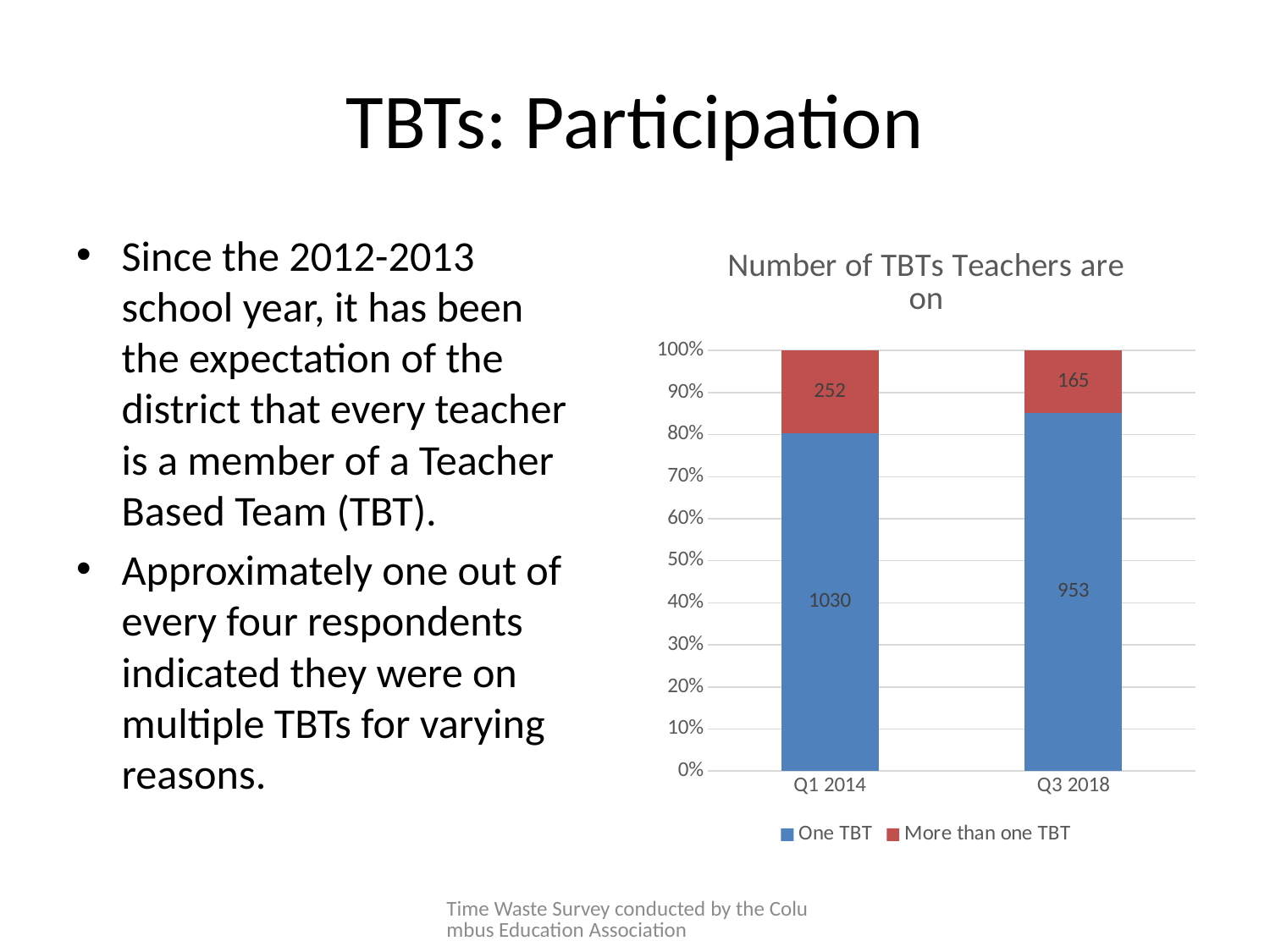
Which category has the higher value for One TBT, Q1 2014 or Q3 2018? Q1 2014 What is the value for More than one TBT in Q3 2018? 165 What is the total of the two values in the Q3 2018 bar? 1118 What is the difference between the More than one TBT values for Q1 2014 and Q3 2018? 87 What is the value for One TBT in Q3 2018? 953 What is the title of the chart? Number of TBTs Teachers are on What is the value for One TBT in Q1 2014? 1030 What is the total of the two values in the Q1 2014 bar? 1282 What is the value for More than one TBT in Q1 2014? 252 How many series does the legend list? 2 What is the difference between the One TBT values for Q1 2014 and Q3 2018? 77 What kind of chart is shown on the slide? Stacked bar chart